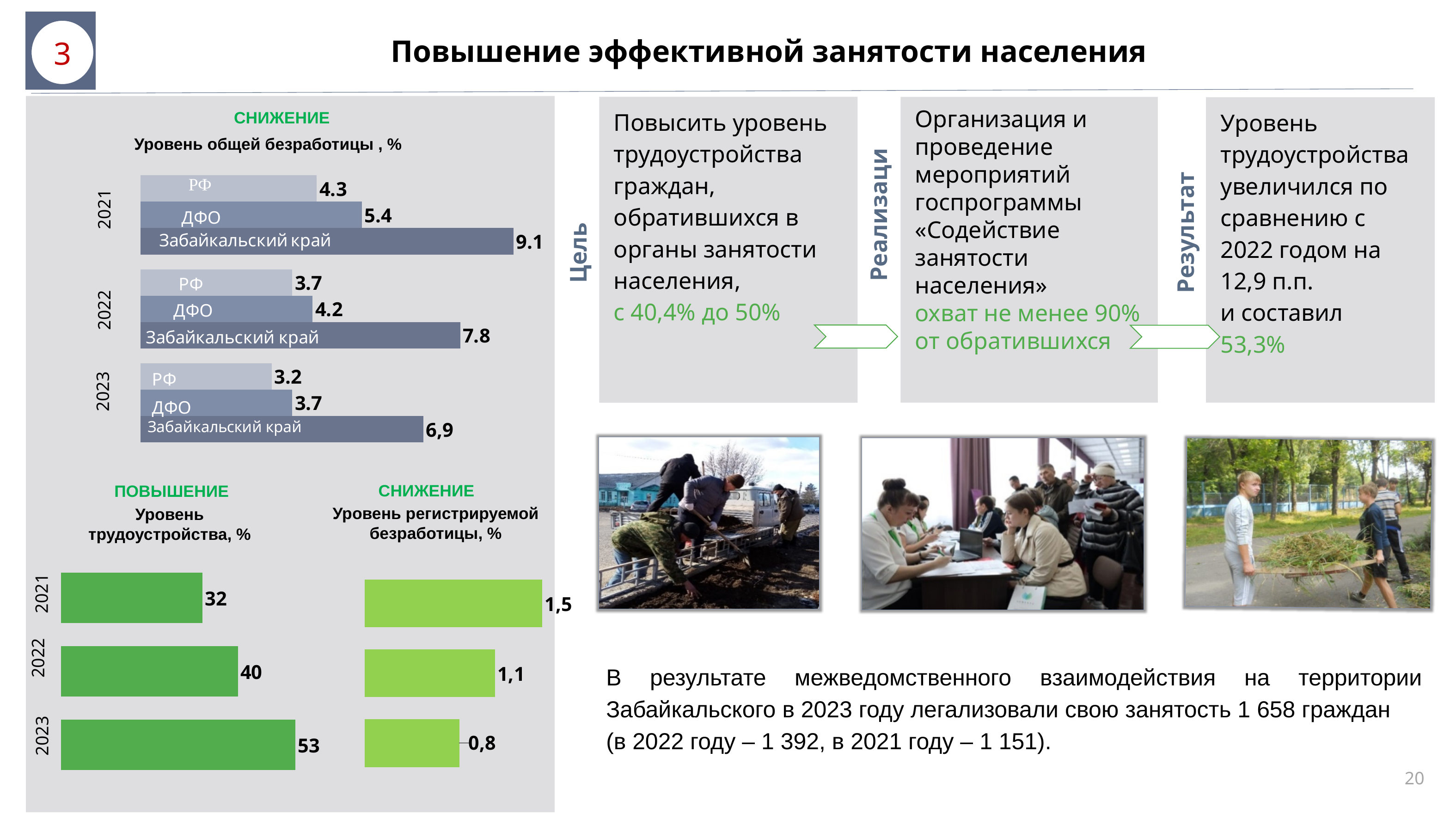
In the chart 'Уровень регистрируемой безработицы, %', what is the value for 2022? 1,1 In the chart 'Уровень регистрируемой безработицы, %', which year has the lowest value? 2023 In the chart 'Уровень общей безработицы, %', what is the difference between Забайкальский край and РФ in 2023? 3.7 In the chart 'Уровень трудоустройства, %', what is the difference between 2023 and 2021? 21 In the chart 'Уровень общей безработицы, %', what is the value for ДФО in 2022? 4.2 In the chart 'Уровень трудоустройства, %', what is the value for 2023? 53 In the chart 'Уровень общей безработицы, %', what is the value for Забайкальский край in 2021? 9.1 In the chart 'Уровень общей безработицы, %', how many series are shown for each year? 3 What type of chart is 'Уровень трудоустройства, %'? bar chart In the chart 'Уровень общей безработицы, %', what is the value for РФ in 2023? 3.2 In the chart 'Уровень общей безработицы, %', does the value for Забайкальский край rise or fall from 2021 to 2023? fall In the chart 'Уровень общей безработицы, %', which series has the highest value in 2022? Забайкальский край